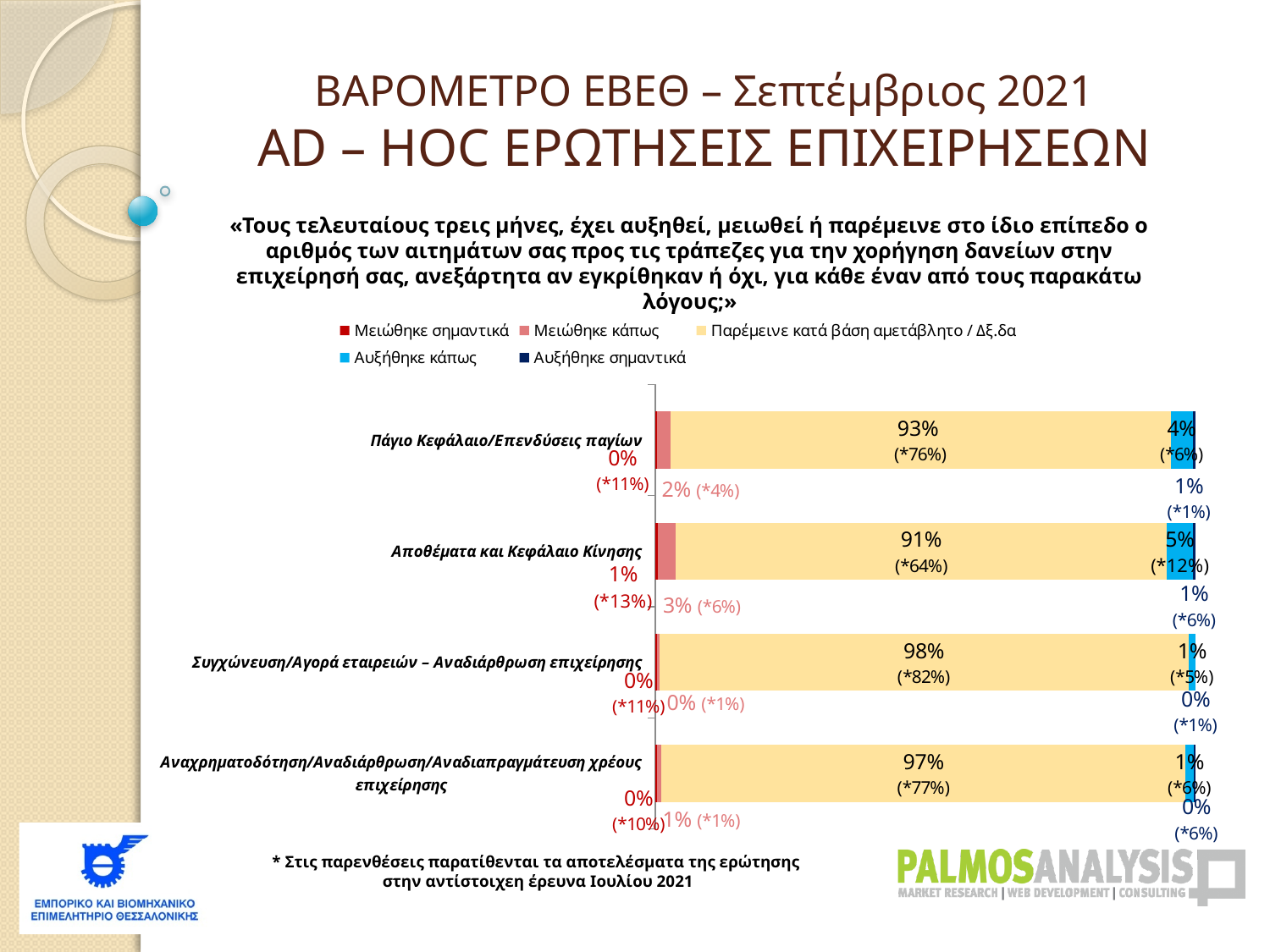
What is the difference between the 'Παρέμεινε κατά βάση αμετάβλητο / Δξ.δα' values for 'Συγχώνευση/Αγορά εταιρειών – Αναδιάρθρωση επιχείρησης' and 'Αποθέματα και Κεφάλαιο Κίνησης'? 7% What kind of chart is shown on the slide? Stacked bar chart Which is larger: the 'Αυξήθηκε κάπως' value for 'Πάγιο Κεφάλαιο/Επενδύσεις παγίων' or for 'Αποθέματα και Κεφάλαιο Κίνησης'? Αποθέματα και Κεφάλαιο Κίνησης Which category has the lowest value for 'Παρέμεινε κατά βάση αμετάβλητο / Δξ.δα'? Αποθέματα και Κεφάλαιο Κίνησης Which category has the highest value for 'Παρέμεινε κατά βάση αμετάβλητο / Δξ.δα'? Συγχώνευση/Αγορά εταιρειών – Αναδιάρθρωση επιχείρησης What value is shown in parentheses for 'Παρέμεινε κατά βάση αμετάβλητο / Δξ.δα' for 'Αναχρηματοδότηση/Αναδιάρθρωση/Αναδιαπραγμάτευση χρέους επιχείρησης'? (*77%) What is the value of 'Μειώθηκε κάπως' for 'Αποθέματα και Κεφάλαιο Κίνησης'? 3% What is the value of 'Αυξήθηκε κάπως' for 'Αποθέματα και Κεφάλαιο Κίνησης'? 5% How many categories are plotted on the chart? 4 What is the value of 'Παρέμεινε κατά βάση αμετάβλητο / Δξ.δα' for 'Πάγιο Κεφάλαιο/Επενδύσεις παγίων'? 93% What is the value of 'Παρέμεινε κατά βάση αμετάβλητο / Δξ.δα' for 'Συγχώνευση/Αγορά εταιρειών – Αναδιάρθρωση επιχείρησης'? 98% How many series does the legend list? 5